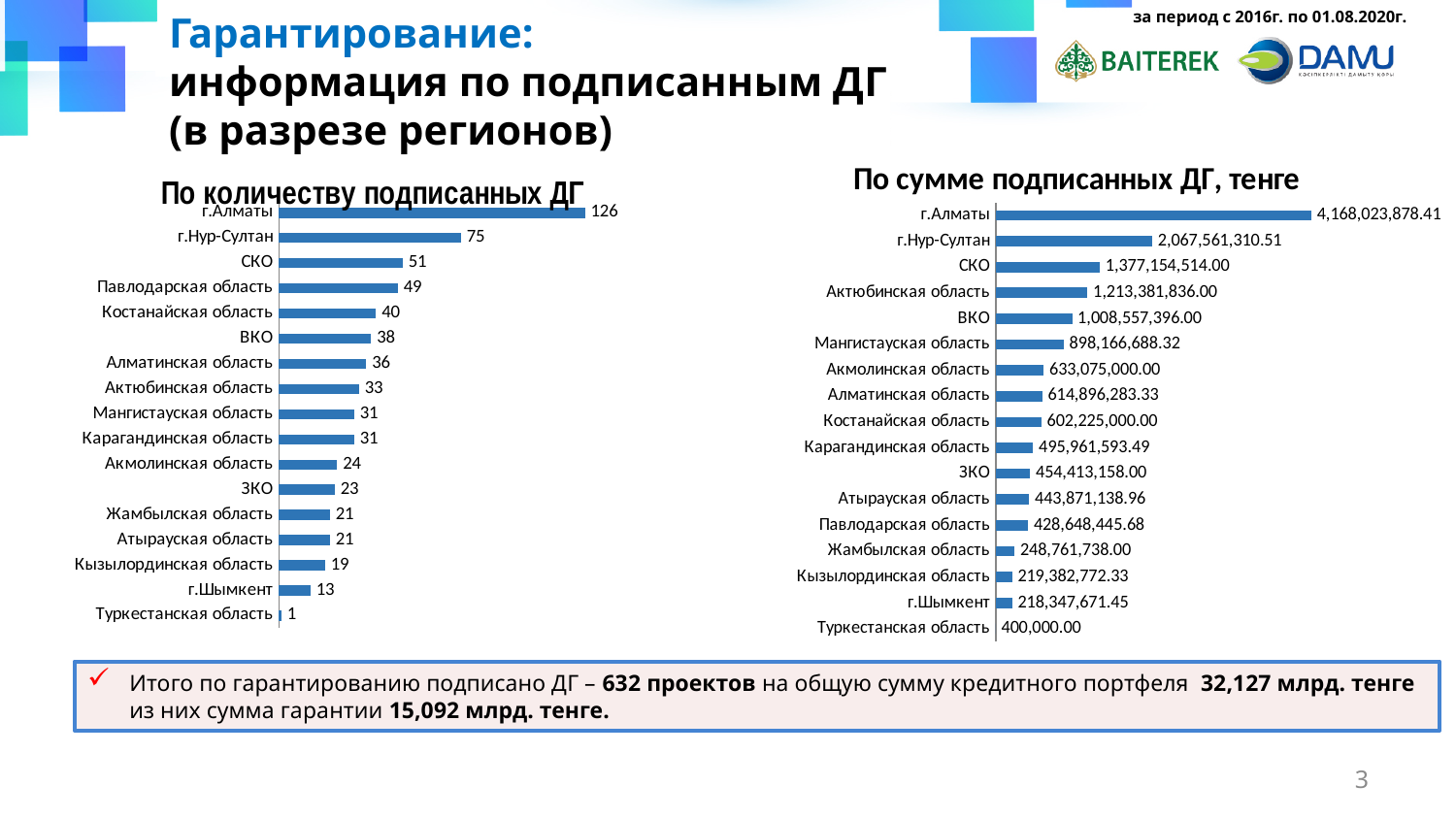
In the chart 'По сумме подписанных ДГ, тенге', what is the value for Мангистауская область? 898,166,688.32 In the chart 'По сумме подписанных ДГ, тенге', which category has the highest value? г.Алматы In the chart 'По сумме подписанных ДГ, тенге', what is the value for г.Нур-Султан? 2,067,561,310.51 In the chart 'По сумме подписанных ДГ, тенге', what is the value for Туркестанская область? 400,000.00 In the chart 'По сумме подписанных ДГ, тенге', which is larger: СКО or Актюбинская область? СКО What type of chart is 'По сумме подписанных ДГ, тенге'? Bar chart In the chart 'По количеству подписанных ДГ', which is larger: Павлодарская область or ВКО? Павлодарская область In the chart 'По количеству подписанных ДГ', what is the value for Костанайская область? 40 In the chart 'По количеству подписанных ДГ', what is the difference between г.Алматы and г.Нур-Султан? 51 In the chart 'По количеству подписанных ДГ', what is the value for г.Алматы? 126 In the chart 'По количеству подписанных ДГ', which category has the lowest value? Туркестанская область In the chart 'По количеству подписанных ДГ', how many categories are shown? 17